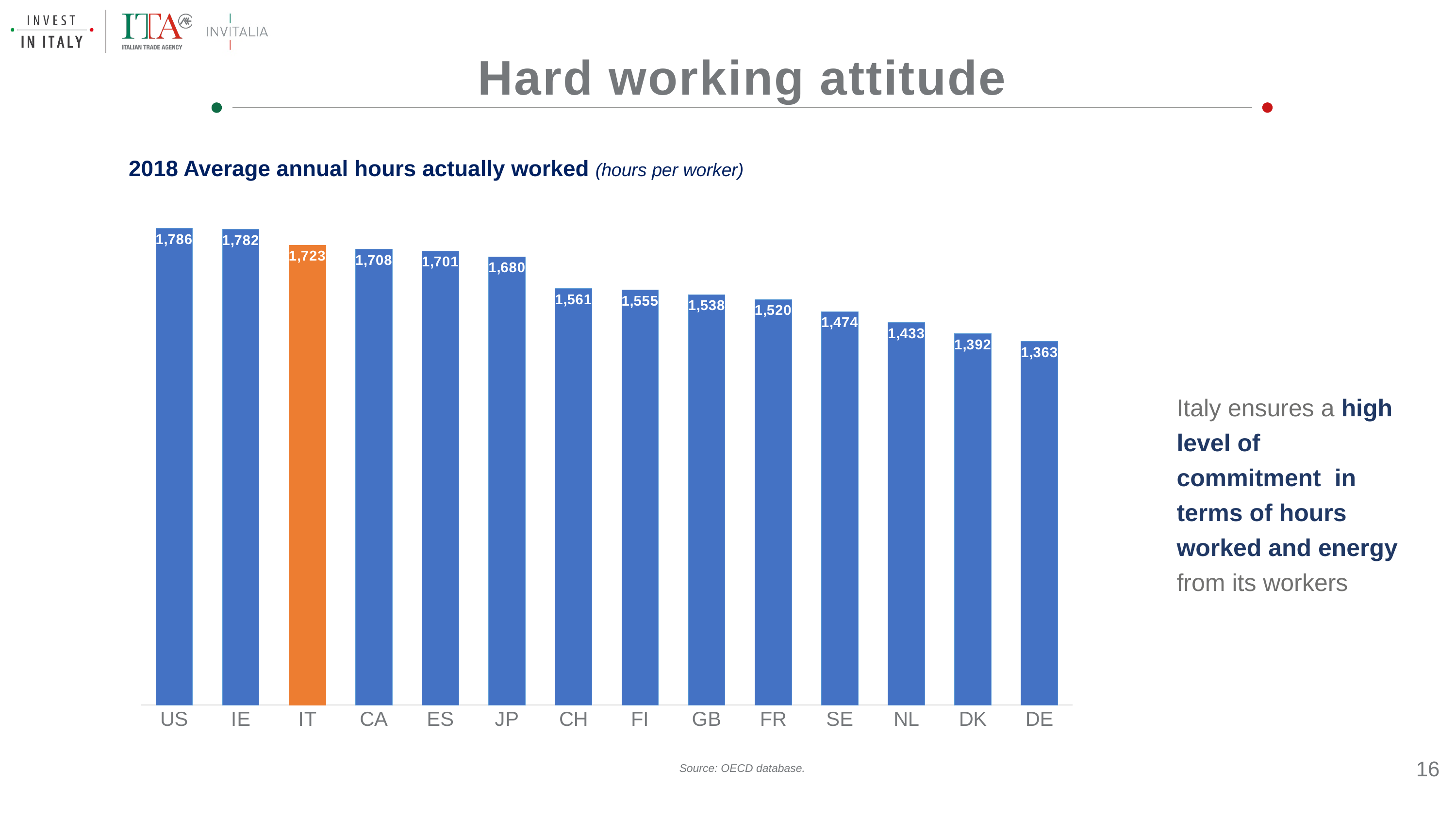
Do the values rise or fall from left to right along the x axis? Fall What is the value for JP in the chart? 1,680 What is the difference between the values for IT and DE? 360 What is the difference between the values for US and IT? 63 Which country has the lowest average annual hours worked? DE Which country has the highest average annual hours worked? US What kind of chart is shown on the slide? Bar chart Which country's bar is coloured orange instead of blue? IT What is the value for DE in the chart? 1,363 How many countries are shown in the chart? 14 Which is larger, the value for CA or the value for FR? CA What is the value for IT in the chart? 1,723